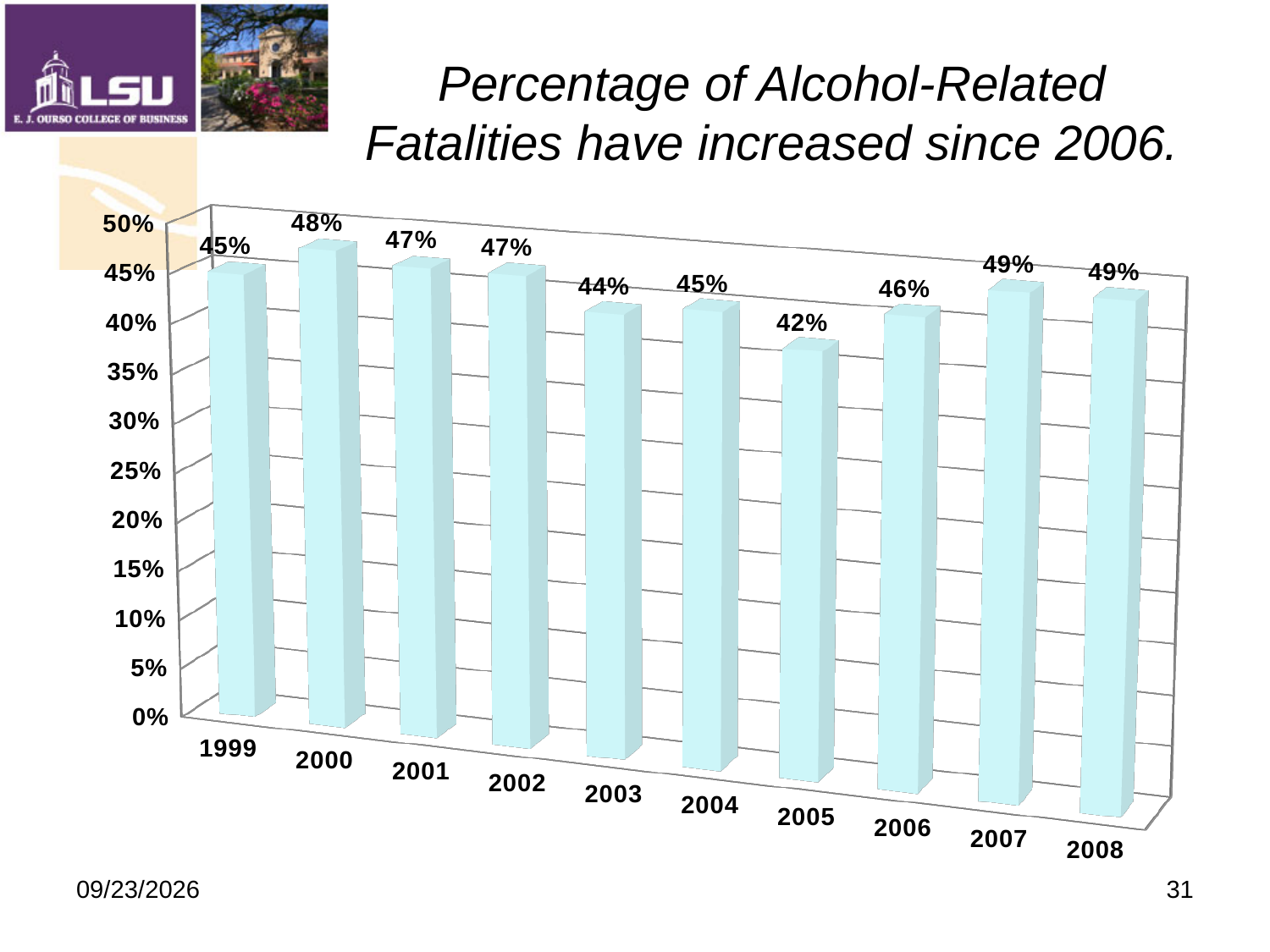
What is the value for 2003? 44% What is the value for 2008? 49% Which is larger, the value for 2006 or the value for 2005? 2006 What is the difference between the values for 2000 and 1999? 3% How many years are shown on the x axis? 10 What is the difference between the values for 2007 and 2005? 7% Do the values rise or fall from 2005 to 2008? rise What is the value for 2005? 42% What kind of chart is shown on the slide? bar chart What is the value for 2000? 48% Which year has the lowest value? 2005 Is the value for 2005 greater or less than 40%? greater